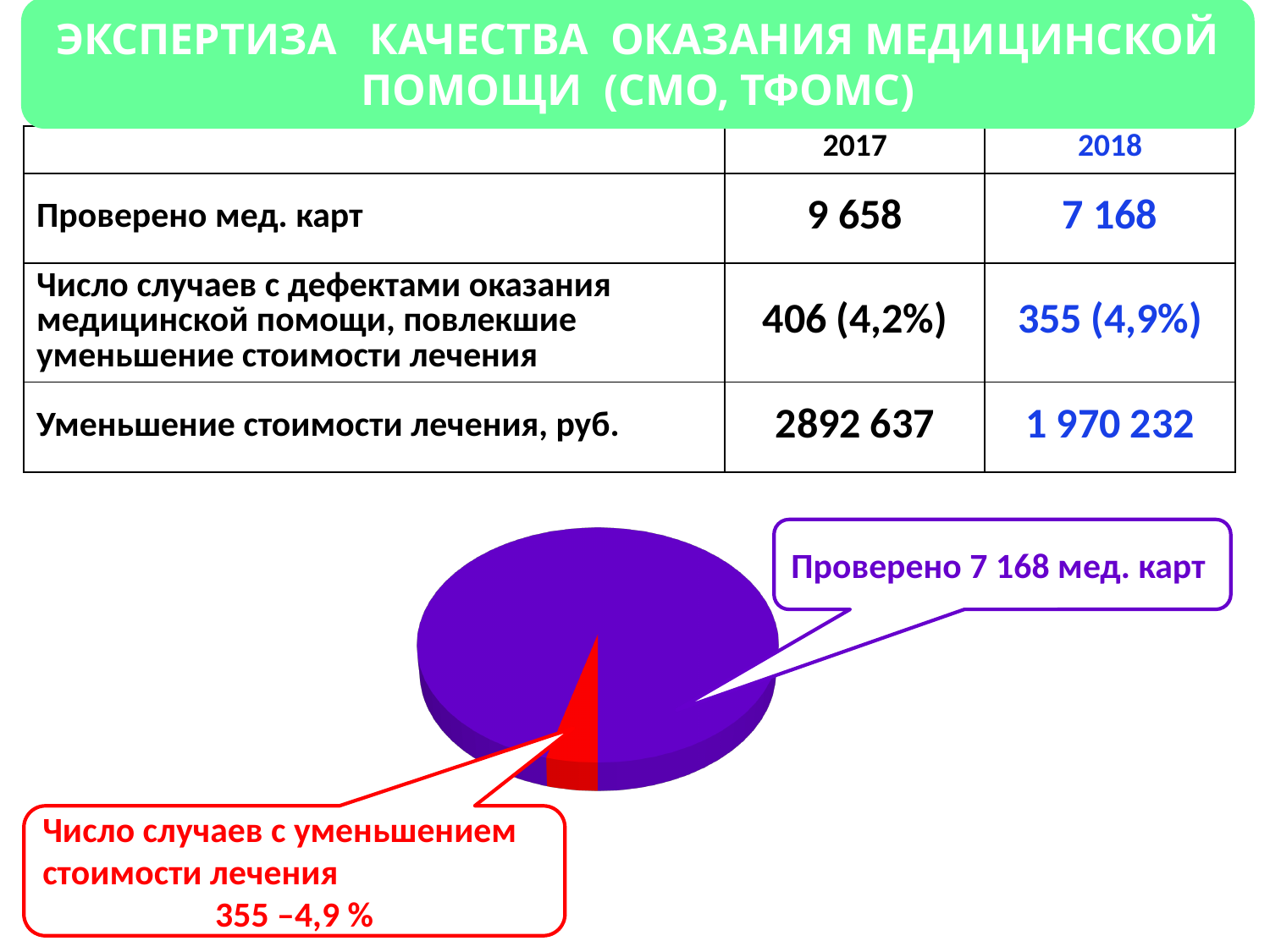
How many slices does the pie chart have? 2 How many medical cards checked are stated in the purple callout of the pie chart? 7 168 What colour is the slice representing cases with reduced treatment cost in the pie chart? red Which slice of the pie chart is the smallest? the red slice (cases with reduced treatment cost) What number of cases with reduced treatment cost is shown in the red callout of the pie chart? 355 What kind of chart is shown on the slide? pie chart What share of the pie does the red slice (cases with reduced treatment cost) represent? 4,9 % Which slice of the pie chart is larger, the purple one or the red one? purple Is the share of the red slice in the pie chart greater or less than 10%? less What colour is the slice linked to the callout 'Проверено 7 168 мед. карт'? purple